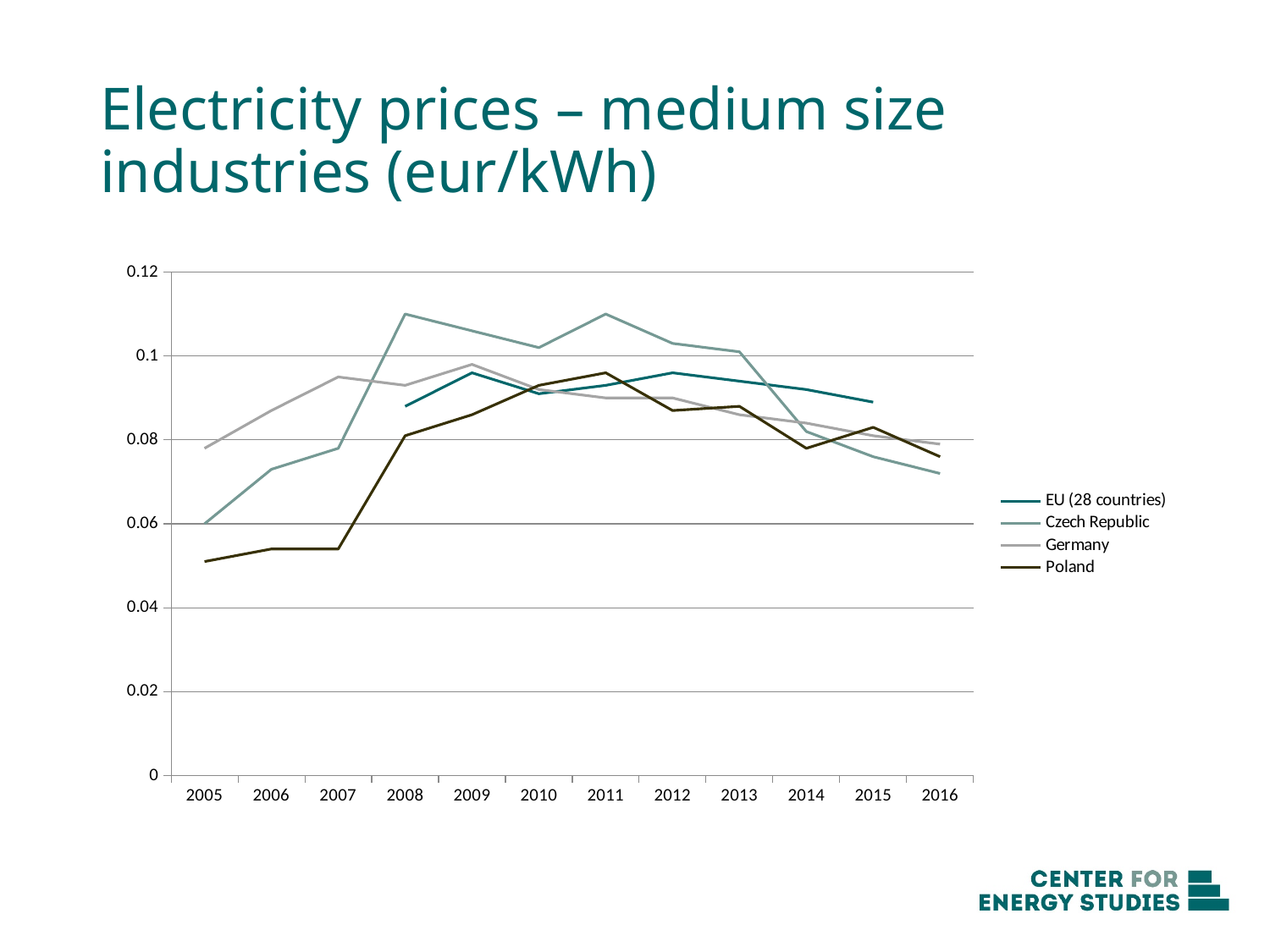
Is the value for Czech Republic in 2011 greater or less than 0.1? greater What is the title of the chart on the slide? Electricity prices – medium size industries (eur/kWh) Is the value for EU (28 countries) in 2015 greater or less than 0.08? greater What kind of chart is shown on the slide? line chart How many series does the legend list? 4 In 2011, which is larger: the value for Czech Republic or the value for Germany? Czech Republic Which series has the highest value in 2008? Czech Republic Does the Poland series rise or fall from 2005 to 2011? rise Is the value for Poland in 2005 greater or less than 0.06? less How many years are shown on the x axis? 12 In 2005, which is larger: the value for Germany or the value for Poland? Germany Which series has the lowest value in 2005? Poland